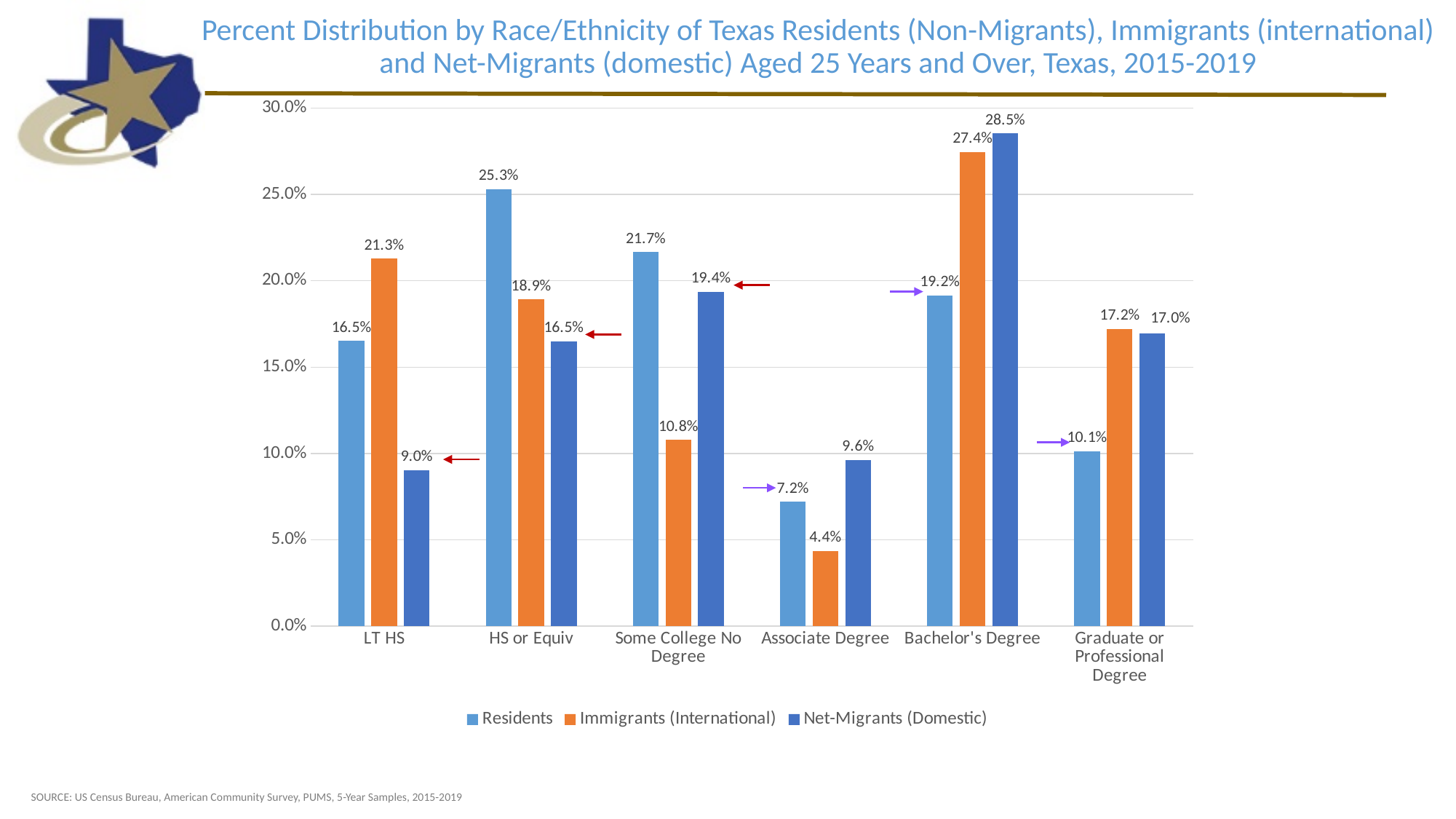
How many series does the legend list? 3 Is the Net-Migrants (Domestic) value for Associate Degree greater or less than 10.0%? less What is the difference between the Residents and Immigrants (International) values for Some College No Degree? 10.9% What is the Immigrants (International) value for Bachelor's Degree? 27.4% For Graduate or Professional Degree, which is larger: the Residents value or the Immigrants (International) value? Immigrants (International) What is the Residents value for HS or Equiv? 25.3% What is the Net-Migrants (Domestic) value for LT HS? 9.0% What kind of chart is shown on the slide? bar chart Which education category has the lowest Immigrants (International) value? Associate Degree Which education category has the highest Net-Migrants (Domestic) value? Bachelor's Degree How many education categories are shown on the x axis? 6 Which series is shown in orange in the legend? Immigrants (International)